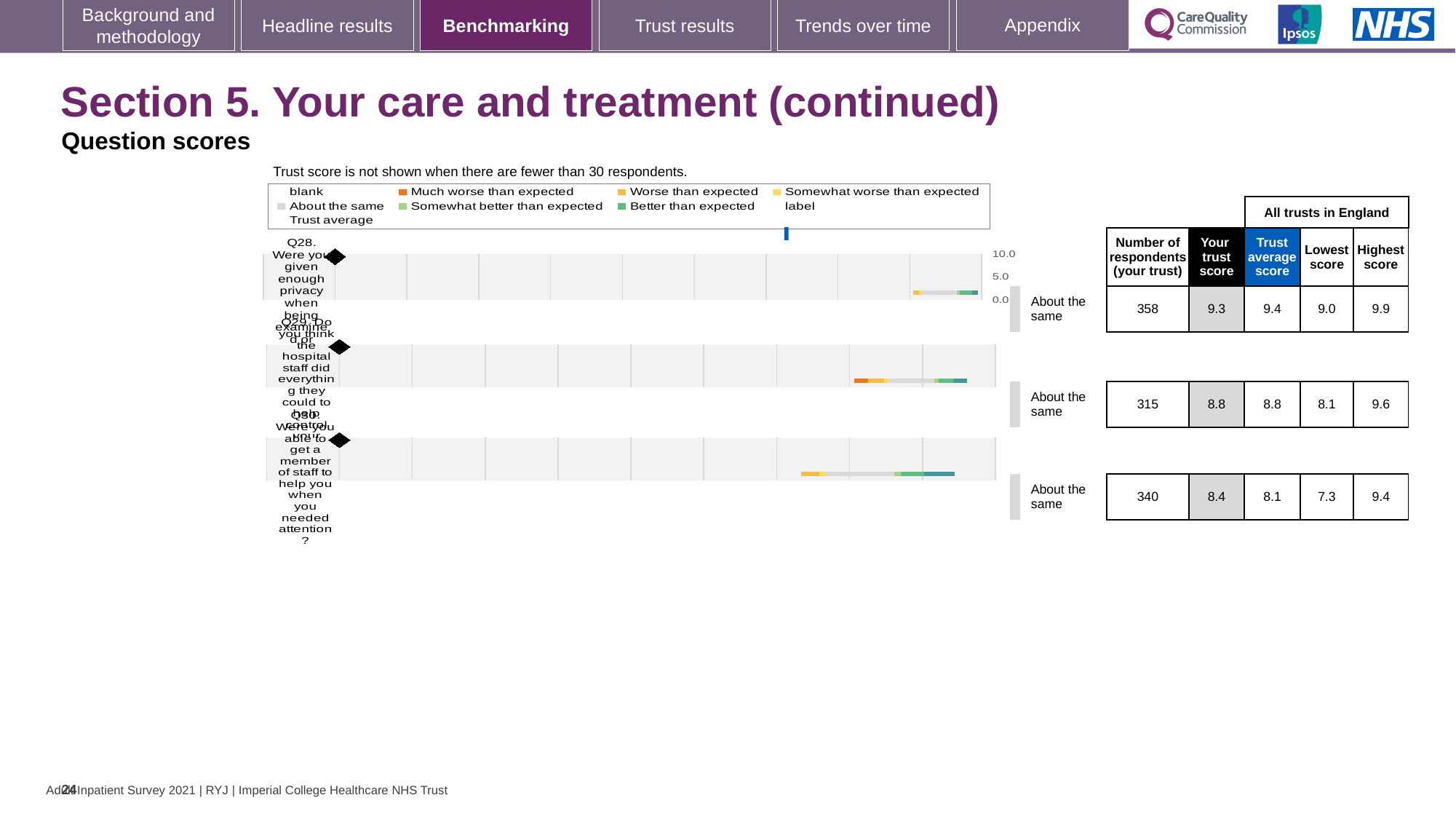
What is the 'Your trust score' for Q28 (Were you given enough privacy when being examined or treated)? 9.3 What is the difference between the trust average score and your trust score for Q28? 0.1 What is the lowest score across all trusts in England for Q30? 7.3 Which question has the lowest 'Your trust score' on this slide? Q30 What kind of chart is used to show the question scores? Bar chart What benchmark category is shown for Q29? About the same How many questions are shown on this slide? 3 Which question has the highest 'Your trust score' on this slide? Q28 For Q30, which is larger: your trust score or the trust average score? Your trust score What is the highest score across all trusts in England for Q28? 9.9 How many respondents from your trust answered Q29 (Do you think the hospital staff did everything they could to help control your pain)? 315 What is the trust average score for Q30 (Were you able to get a member of staff to help you when you needed attention)? 8.1